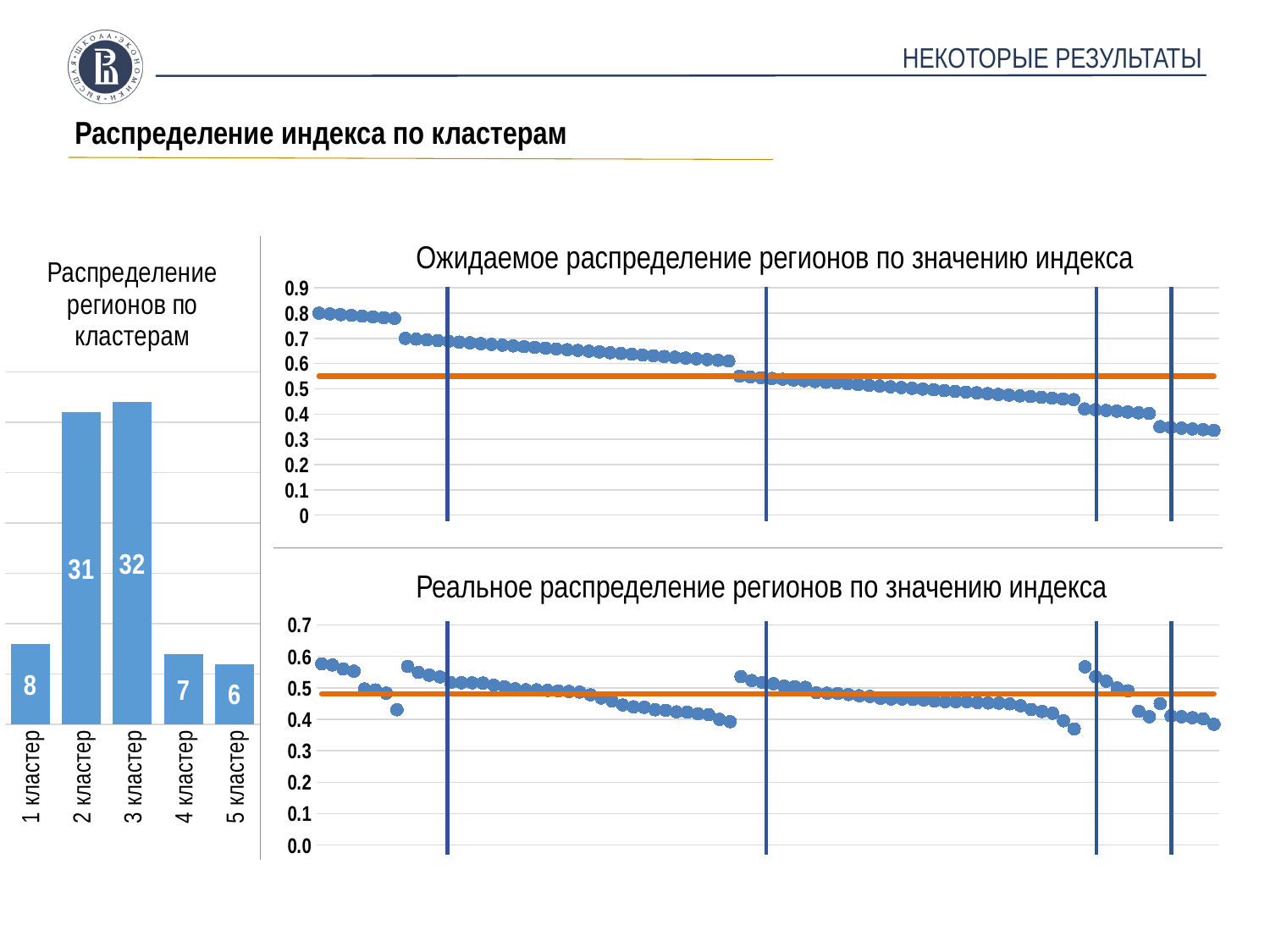
In the chart 'Ожидаемое распределение регионов по значению индекса', are the leftmost points greater or less than 0.7? greater In the chart 'Распределение регионов по кластерам', which cluster has the highest value? 3 кластер In the chart 'Распределение регионов по кластерам', which is larger: the value for 1 кластер or the value for 4 кластер? 1 кластер In the chart 'Распределение регионов по кластерам', what is the difference between the values for 2 кластер and 1 кластер? 23 In the chart 'Ожидаемое распределение регионов по значению индекса', do the values rise or fall from left to right? Fall What kind of chart is 'Распределение регионов по кластерам'? Bar chart In the chart 'Распределение регионов по кластерам', what is the value for 2 кластер? 31 In the chart 'Распределение регионов по кластерам', which cluster has the lowest value? 5 кластер In the chart 'Распределение регионов по кластерам', what is the value for 4 кластер? 7 In the chart 'Реальное распределение регионов по значению индекса', are the rightmost points greater or less than 0.3? greater How many clusters are shown in the chart 'Распределение регионов по кластерам'? 5 In the chart 'Распределение регионов по кластерам', what is the difference between the values for 3 кластер and 2 кластер? 1